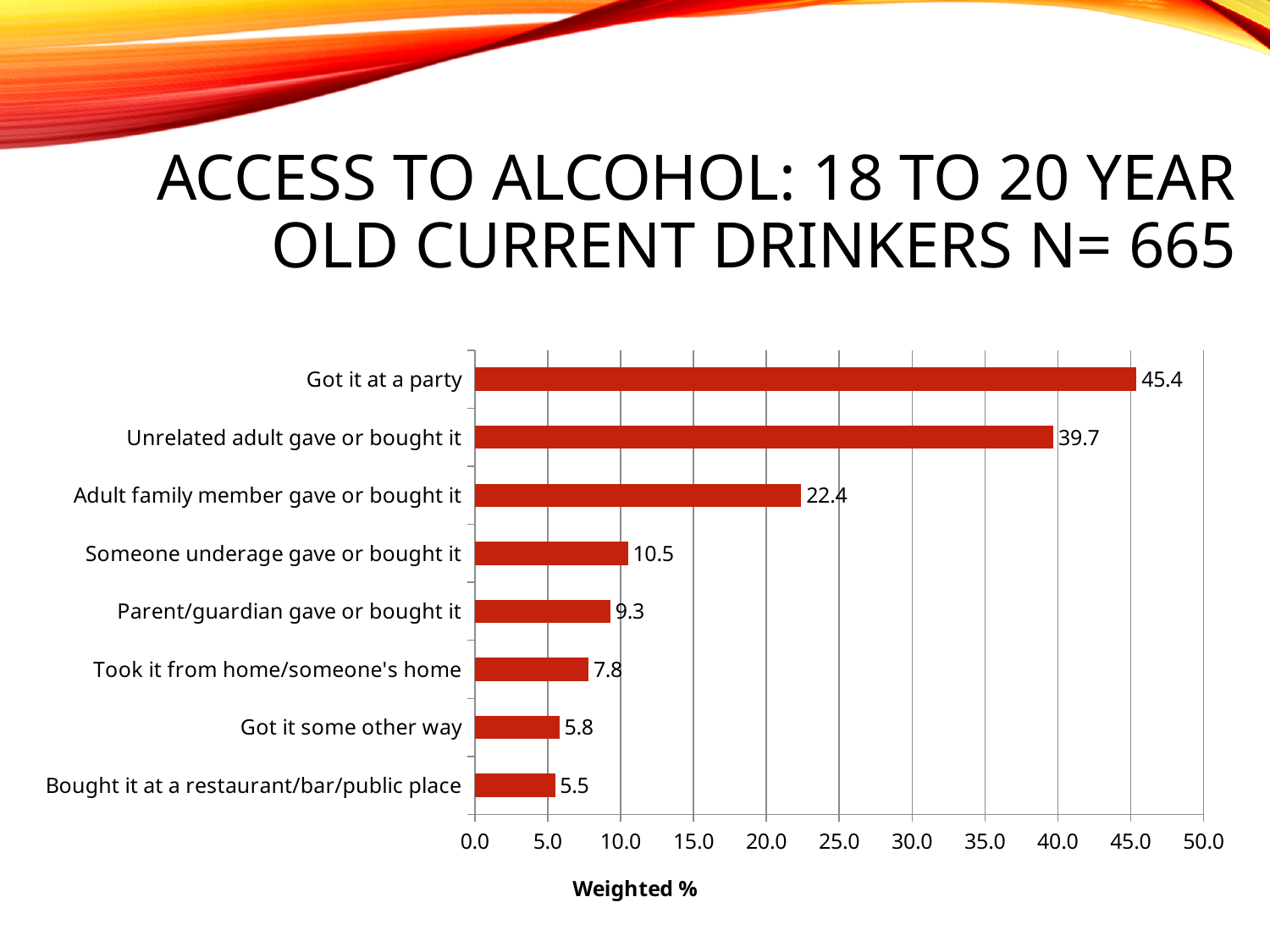
Is the value for 'Unrelated adult gave or bought it' greater or less than 35.0? greater What is the weighted % for 'Got it at a party'? 45.4 How many categories are shown in the chart? 8 Which category has the lowest weighted %? Bought it at a restaurant/bar/public place What is the difference in weighted % between 'Adult family member gave or bought it' and 'Someone underage gave or bought it'? 11.9 What is the label of the horizontal axis? Weighted % What is the weighted % for 'Took it from home/someone's home'? 7.8 What is the weighted % for 'Parent/guardian gave or bought it'? 9.3 What is the difference in weighted % between 'Got it at a party' and 'Unrelated adult gave or bought it'? 5.7 Which category has the highest weighted %? Got it at a party What kind of chart is shown on the slide? Bar chart Which has a higher weighted %, 'Got it some other way' or 'Took it from home/someone's home'? Took it from home/someone's home